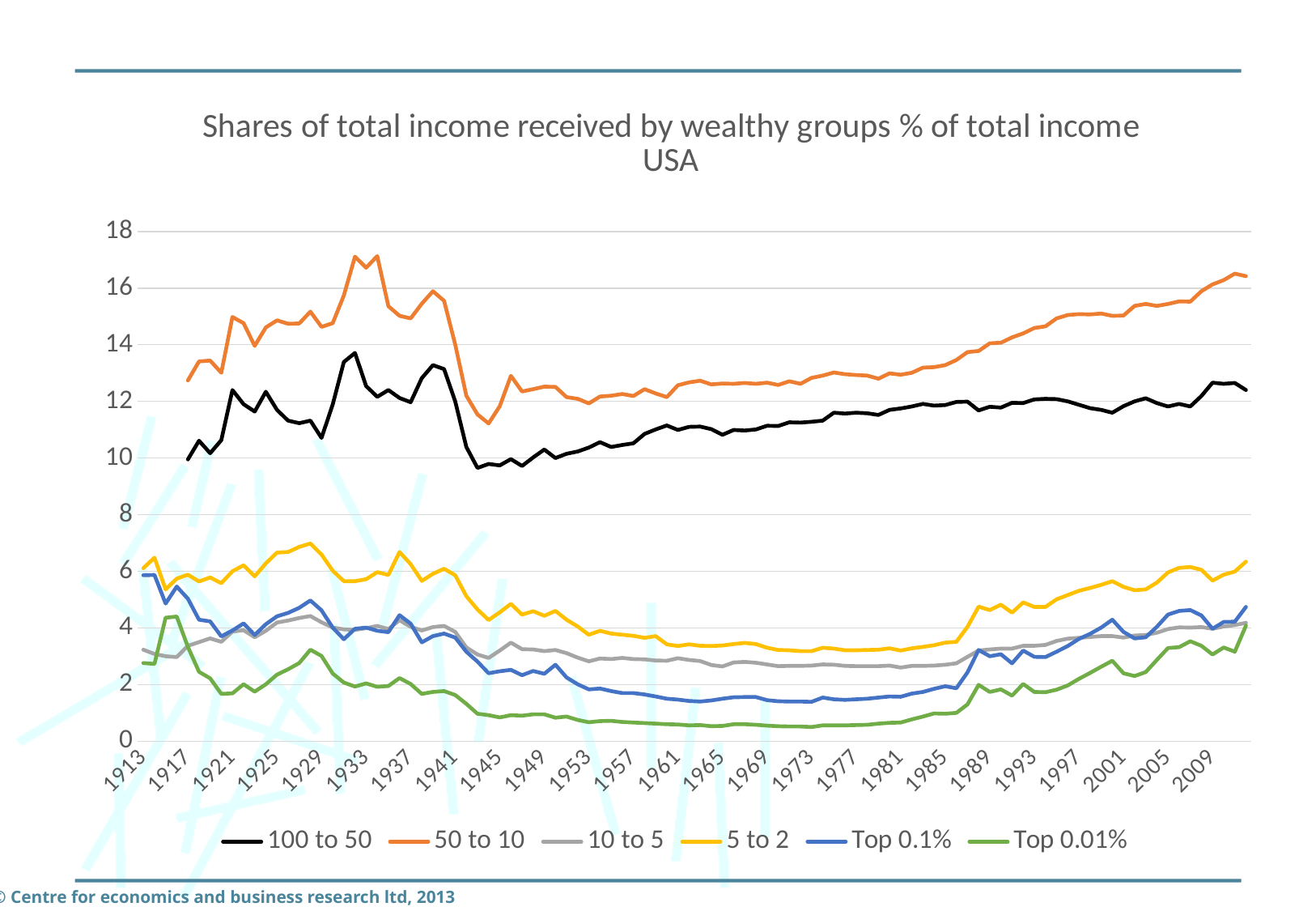
Does the Top 0.1% series rise or fall between 1929 and 1945? fall What kind of chart is shown on the slide? line chart Is the value for the 50 to 10 series in 2009 greater or less than 14? greater Is the value for the 5 to 2 series in 1929 greater or less than 6? greater How many series does the legend list? 6 Is the value for the Top 0.01% series in 1973 greater or less than 2? less In 1933, which series has the larger value, 50 to 10 or 100 to 50? 50 to 10 Does the 50 to 10 series rise or fall between 1985 and 2009? rise What is the title of the chart? Shares of total income received by wealthy groups % of total income USA Which series has the highest values across the whole chart? 50 to 10 Which series has the lowest values across the whole chart? Top 0.01%